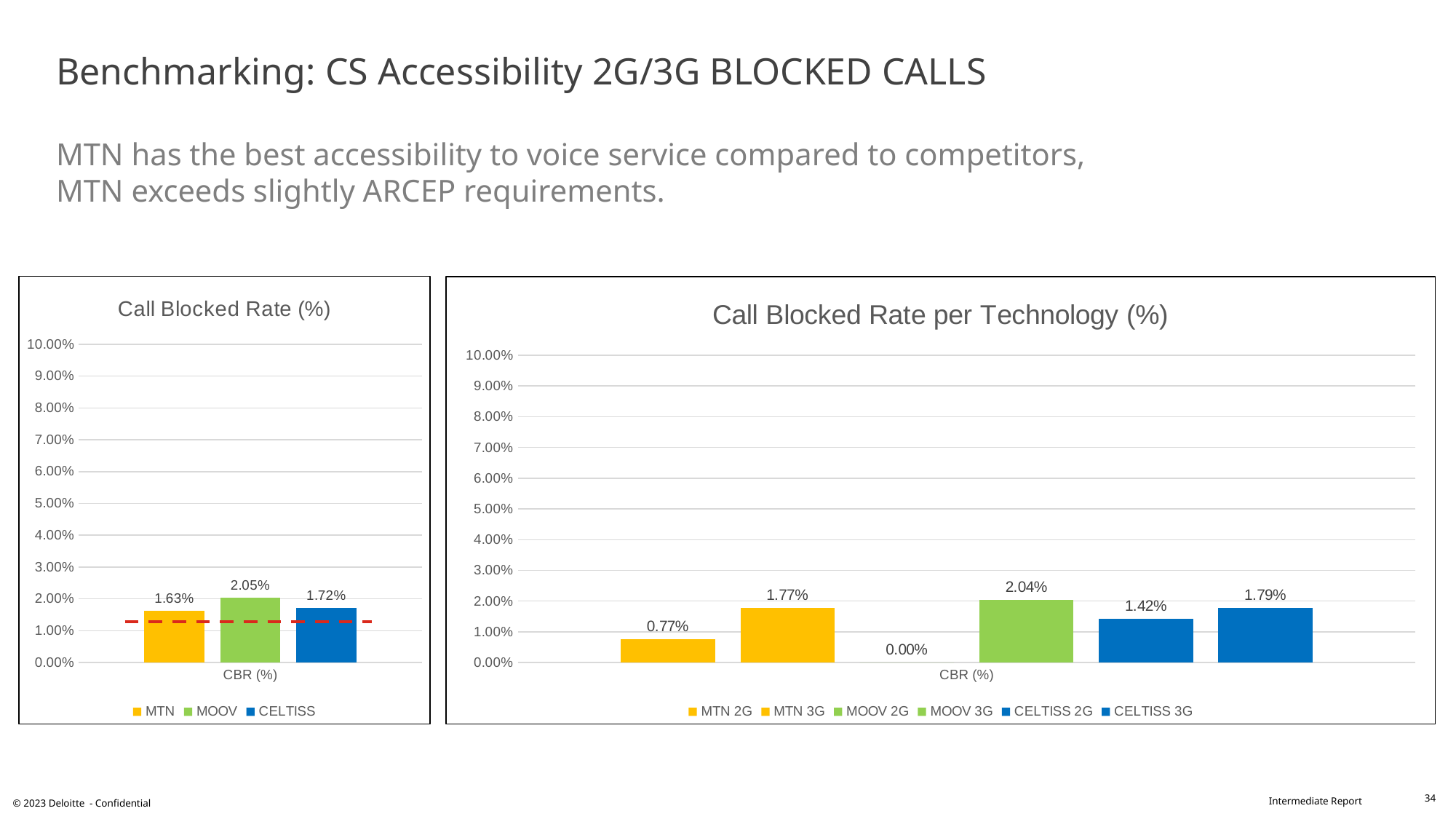
In the 'Call Blocked Rate per Technology (%)' chart, how many series does the legend list? 6 In the 'Call Blocked Rate per Technology (%)' chart, which series has the lowest value? MOOV 2G In the 'Call Blocked Rate (%)' chart, which operator has the lowest call blocked rate? MTN In the 'Call Blocked Rate (%)' chart, what is the value for MTN? 1.63% In the 'Call Blocked Rate per Technology (%)' chart, which series has the highest value? MOOV 3G What kind of chart is the 'Call Blocked Rate per Technology (%)' chart? Bar chart In the 'Call Blocked Rate per Technology (%)' chart, which is larger, MTN 3G or CELTISS 3G? CELTISS 3G In the 'Call Blocked Rate per Technology (%)' chart, what is the value for MTN 2G? 0.77% In the 'Call Blocked Rate per Technology (%)' chart, what is the value for CELTISS 2G? 1.42% In the 'Call Blocked Rate (%)' chart, which operator has the highest call blocked rate? MOOV In the 'Call Blocked Rate (%)' chart, how many series does the legend list? 3 In the 'Call Blocked Rate (%)' chart, what is the difference between the MOOV and MTN values? 0.42%